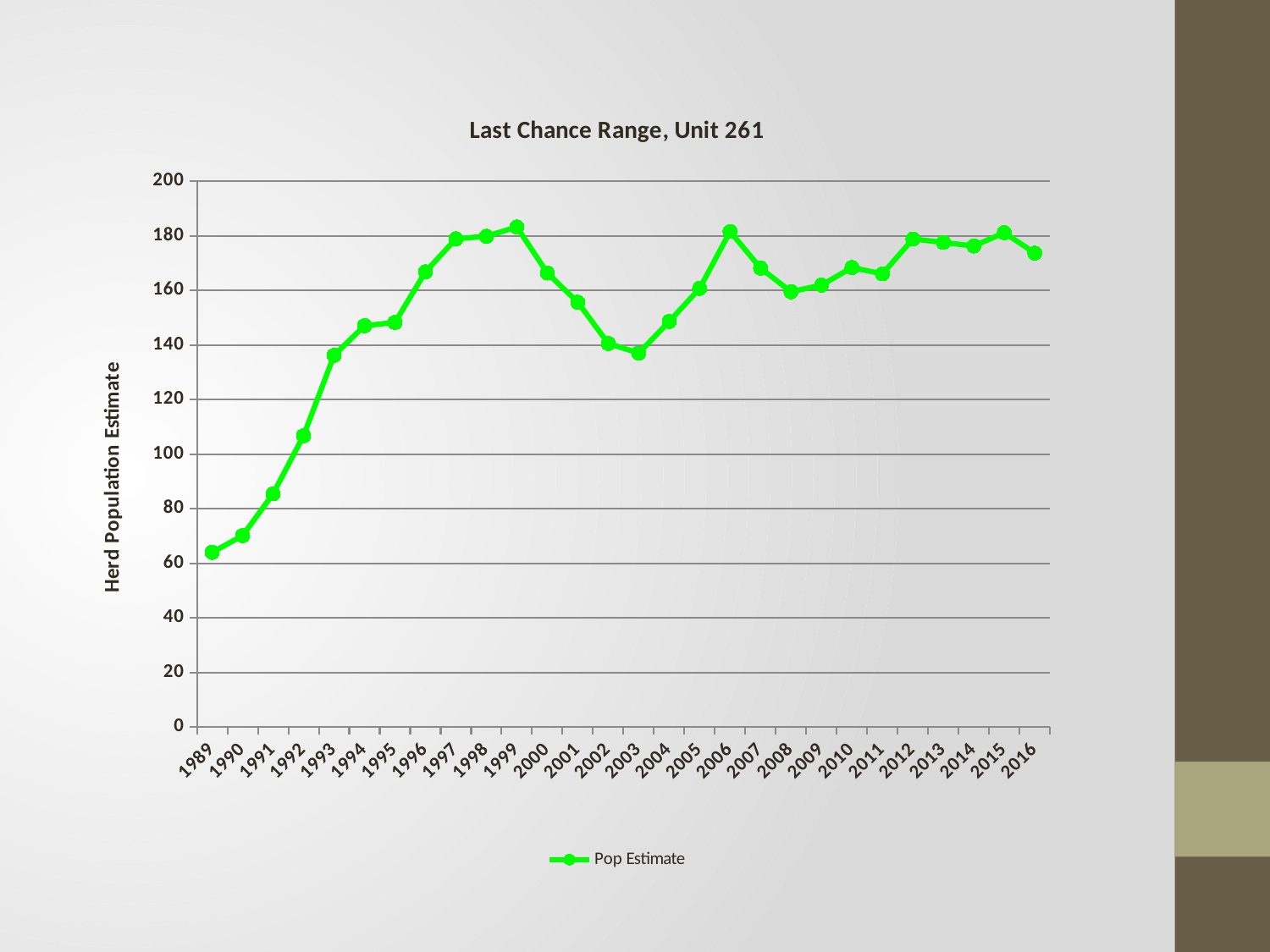
Is the herd population estimate for 1992 greater or less than 100? greater Is the herd population estimate for 1997 greater or less than 160? greater What is the title of the chart? Last Chance Range, Unit 261 Which is larger, the herd population estimate for 1989 or for 2016? 2016 How many years are plotted on the x axis? 28 What is the label of the series in the legend? Pop Estimate Is the herd population estimate for 2003 greater or less than 160? less How many series does the legend list? 1 Which year has the lowest herd population estimate? 1989 What kind of chart is shown on the slide? line chart Does the herd population estimate rise or fall from 1989 to 1999? rise